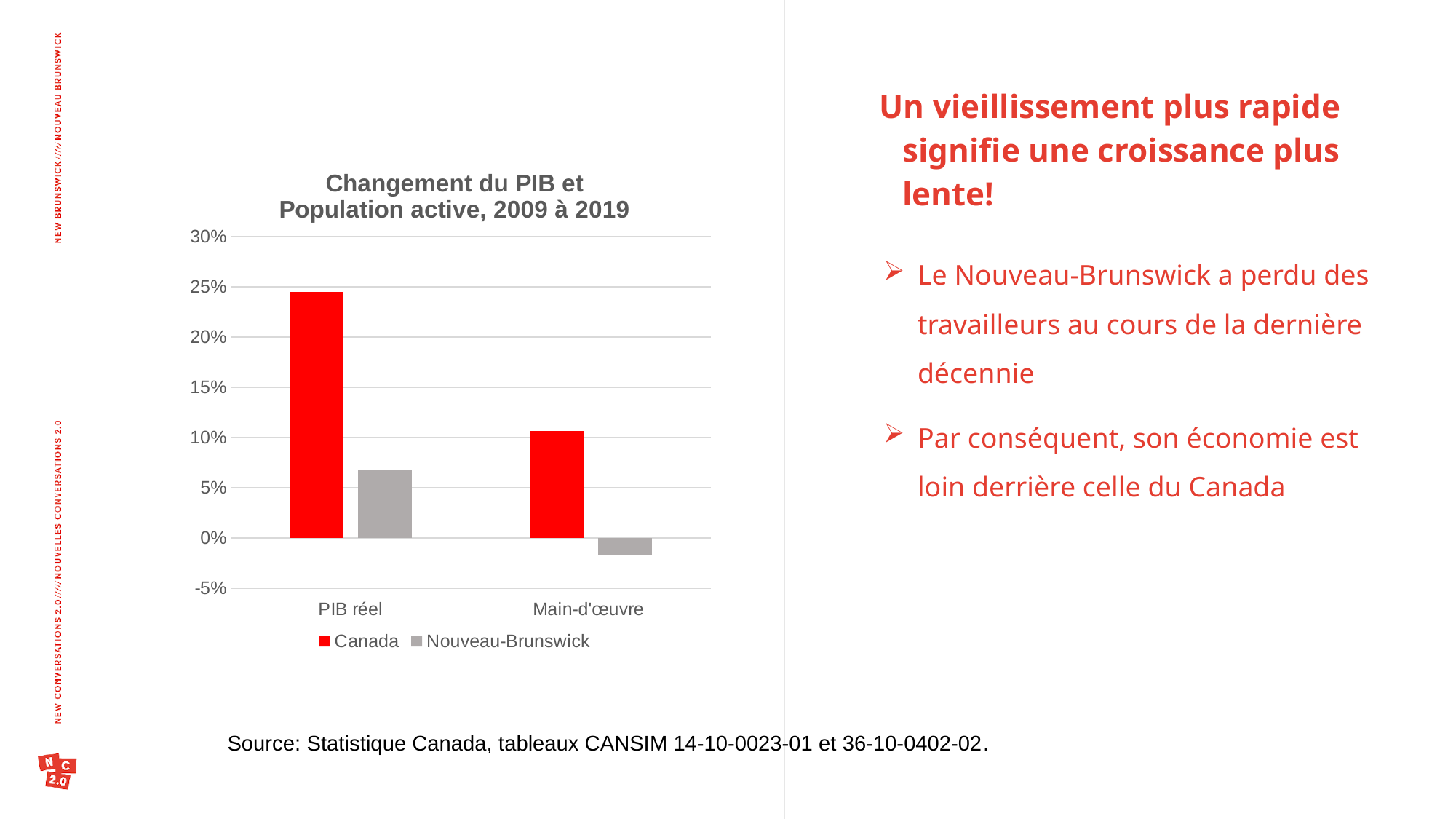
In the Main-d'œuvre category, which is larger: the value for Canada or for Nouveau-Brunswick? Canada How many series does the chart legend list? 2 What kind of chart is shown on the slide? bar chart Which bar is the lowest in the chart? Nouveau-Brunswick, Main-d'œuvre Is the value for Nouveau-Brunswick in the Main-d'œuvre category greater or less than 0%? less Which bar is the highest in the chart? Canada, PIB réel How many categories are shown on the x axis of the chart? 2 Is the value for Canada in the PIB réel category greater or less than 20%? greater Which series is shown in red in the chart? Canada Is the value for Nouveau-Brunswick in the PIB réel category greater or less than 10%? less What is the title of the chart? Changement du PIB et Population active, 2009 à 2019